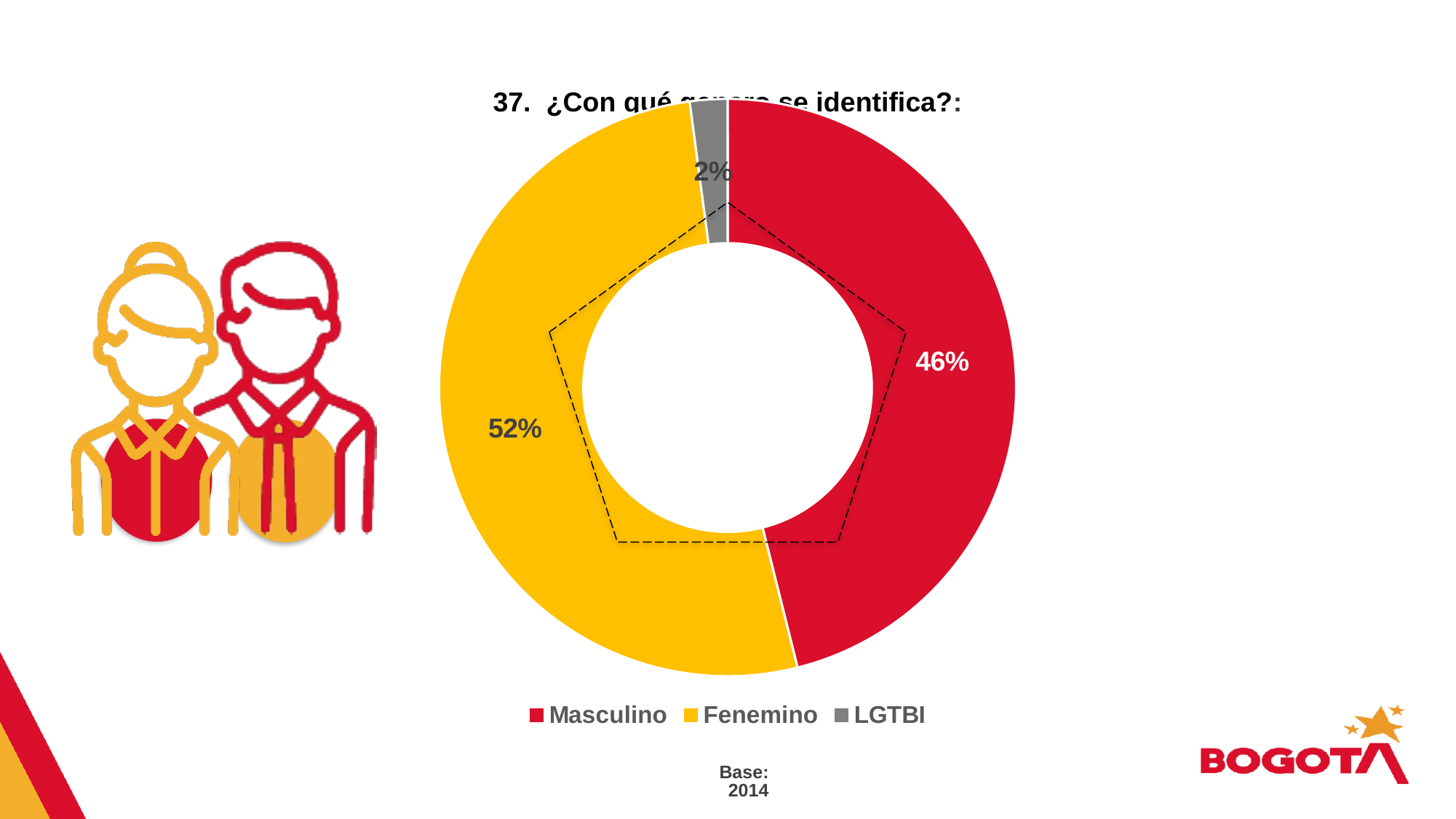
What kind of chart is shown on the slide? Pie chart (doughnut) Which is larger, the share for Masculino or the share for Fenemino? Fenemino What colour represents Masculino in the chart? Red How many categories does the pie chart show? 3 What percentage of respondents identify as Masculino? 46% What is the base (number of respondents) shown below the chart? 2014 Which category has the largest share of the pie? Fenemino What percentage of respondents identify as LGTBI? 2% What is the combined share of Masculino and LGTBI? 48% Which category has the smallest share of the pie? LGTBI What percentage of respondents identify as Fenemino? 52% What is the difference in percentage points between Fenemino and Masculino? 6